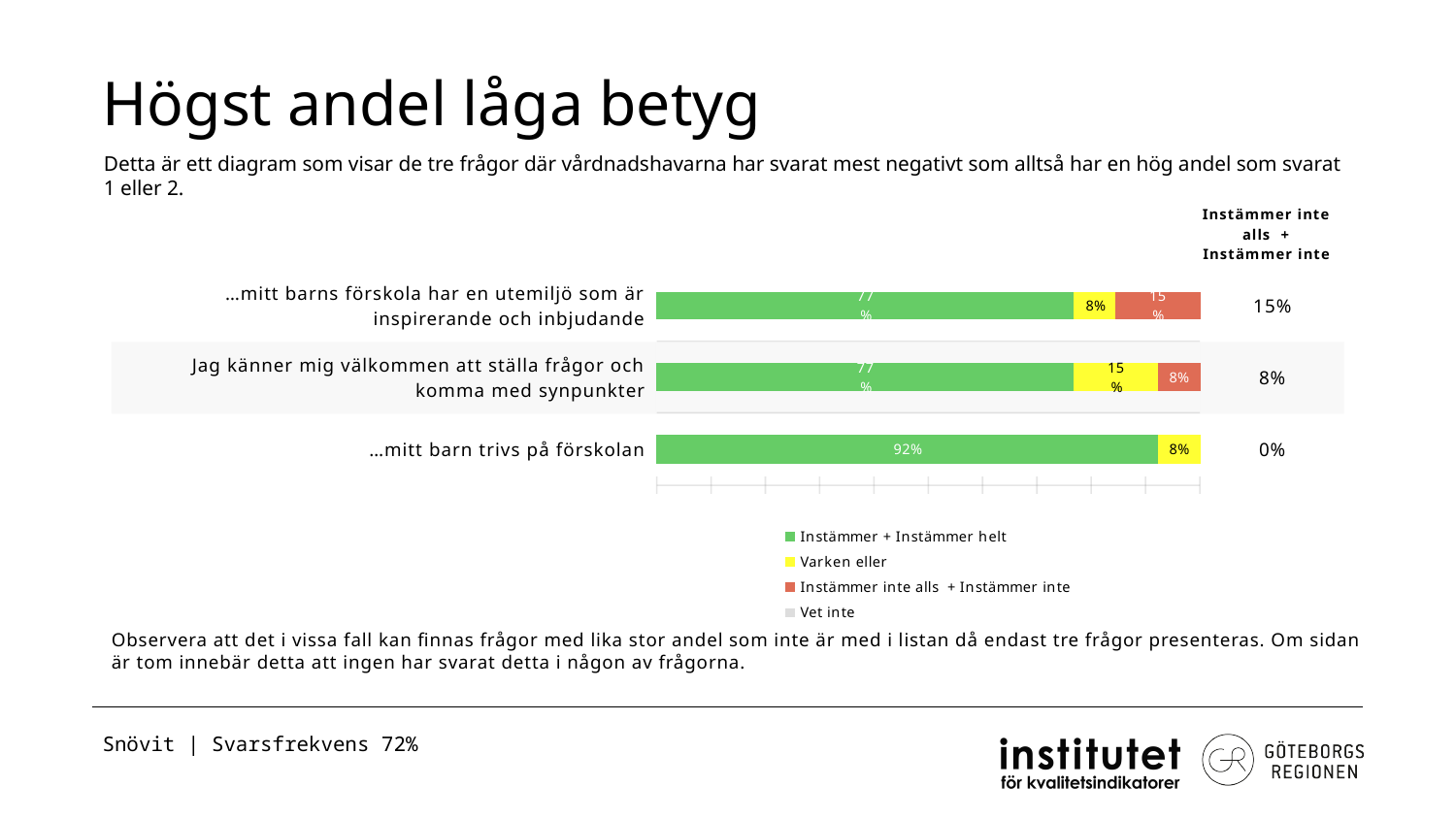
How many categories (questions) are shown in the chart? 3 What is the value of 'Instämmer inte alls + Instämmer inte' for '…mitt barns förskola har en utemiljö som är inspirerande och inbjudande'? 15% Which category has the lowest 'Instämmer inte alls + Instämmer inte' value in the right-hand column? …mitt barn trivs på förskolan What is the value of 'Varken eller' for '…mitt barns förskola har en utemiljö som är inspirerande och inbjudande'? 8% Which category has the highest 'Instämmer + Instämmer helt' value? …mitt barn trivs på förskolan Which is larger: the 'Varken eller' value for '…mitt barns förskola har en utemiljö som är inspirerande och inbjudande' or for 'Jag känner mig välkommen att ställa frågor och komma med synpunkter'? Jag känner mig välkommen att ställa frågor och komma med synpunkter What type of chart is shown on the slide? Stacked bar chart What is the value of 'Instämmer + Instämmer helt' for '…mitt barn trivs på förskolan'? 92% What colour represents 'Instämmer inte alls + Instämmer inte' in the chart? Red/orange What is the difference between the 'Instämmer + Instämmer helt' value for '…mitt barn trivs på förskolan' and for 'Jag känner mig välkommen att ställa frågor och komma med synpunkter'? 15% What is the value of 'Varken eller' for 'Jag känner mig välkommen att ställa frågor och komma med synpunkter'? 15% How many series does the legend list? 4